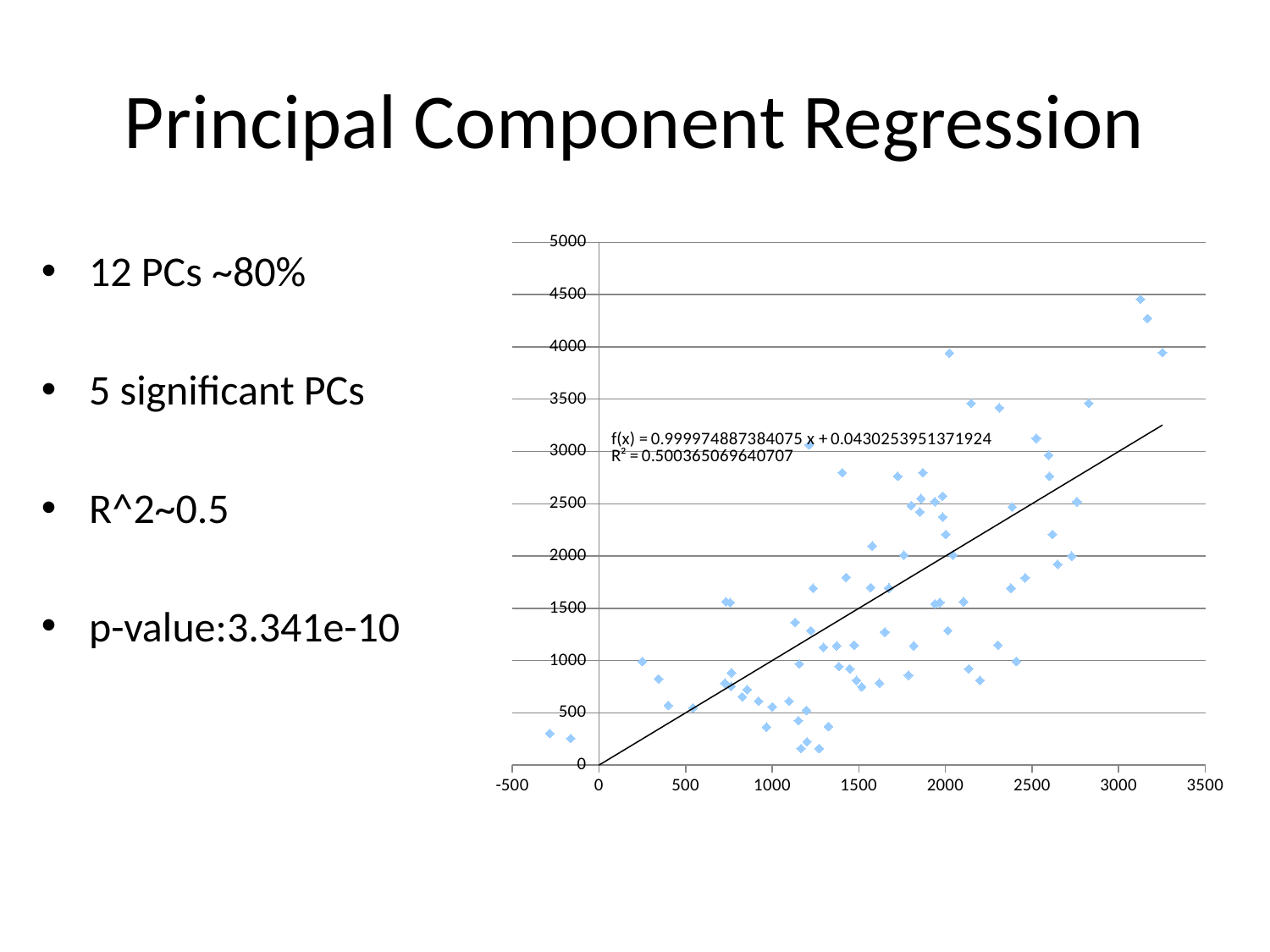
Is the highest plotted point on the chart greater or less than 4000 on the y axis? greater Is the lowest plotted point on the chart greater or less than 500 on the y axis? less What is the maximum value shown on the y axis of the chart? 5000 Do the plotted points generally rise or fall as the x value increases? rise What R² value is printed on the chart? R² = 0.500365069640707 What is the maximum value shown on the x axis of the chart? 3500 What kind of chart is shown on the slide? scatter chart What is the minimum value shown on the x axis of the chart? -500 What trendline equation is printed on the chart? f(x) = 0.999974887384075 x + 0.0430253951371924 Does the trendline on the chart slope upward or downward? upward